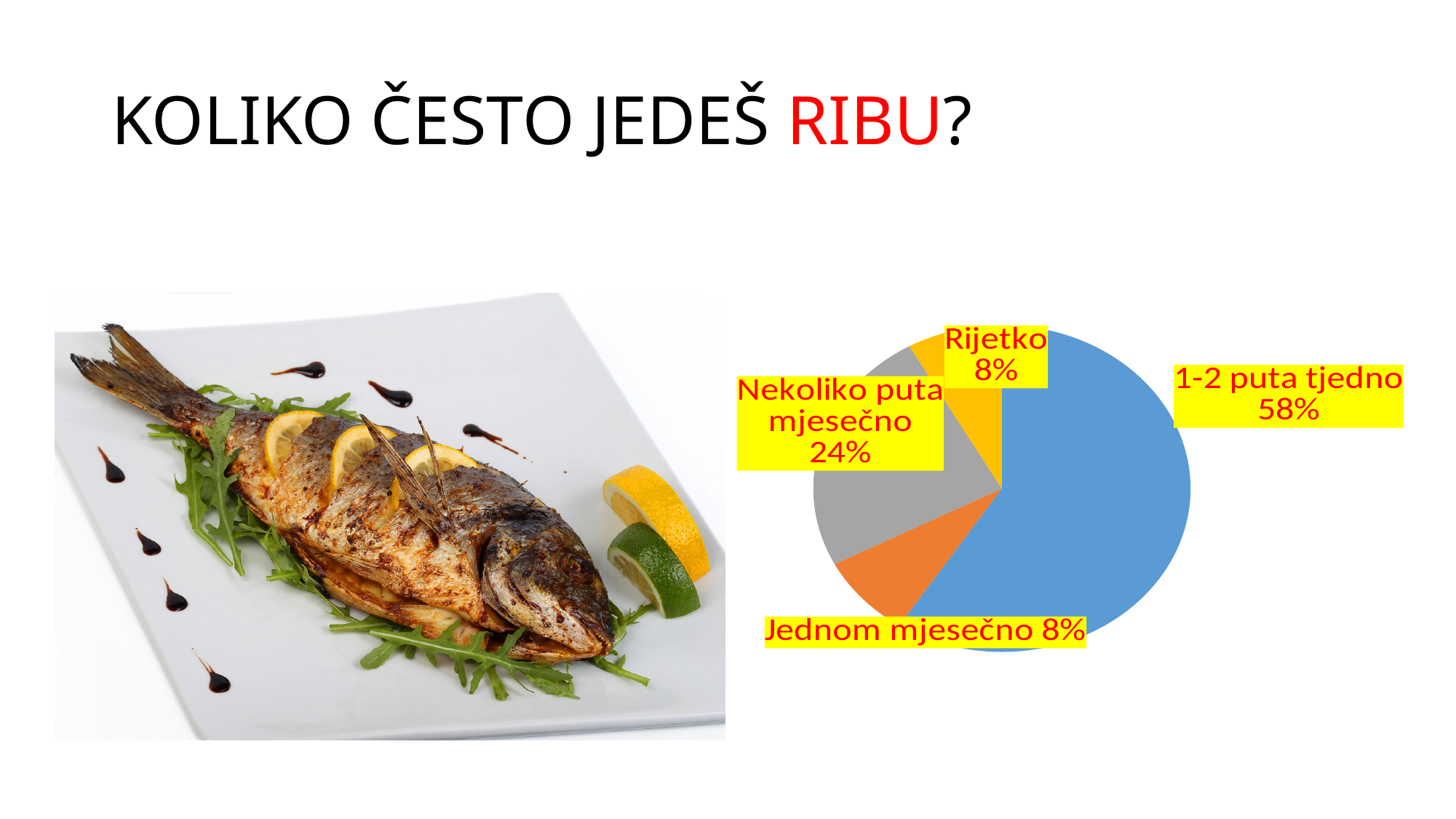
What colour is the slice for "1-2 puta tjedno"? blue What share of the pie is labelled "Nekoliko puta mjesečno"? 24% Which category has the largest share of the pie? 1-2 puta tjedno What share of the pie is labelled "1-2 puta tjedno"? 58% What is the title of the slide containing the pie chart? KOLIKO ČESTO JEDEŠ RIBU? What share of the pie is labelled "Rijetko"? 8% What kind of chart is shown on the slide? pie chart What is the difference between the shares for "1-2 puta tjedno" and "Nekoliko puta mjesečno"? 34% How many slices does the pie chart have? 4 Which is larger, the share for "Nekoliko puta mjesečno" or the share for "Rijetko"? Nekoliko puta mjesečno What share of the pie is labelled "Jednom mjesečno"? 8% What is the combined share of "Rijetko" and "Jednom mjesečno"? 16%